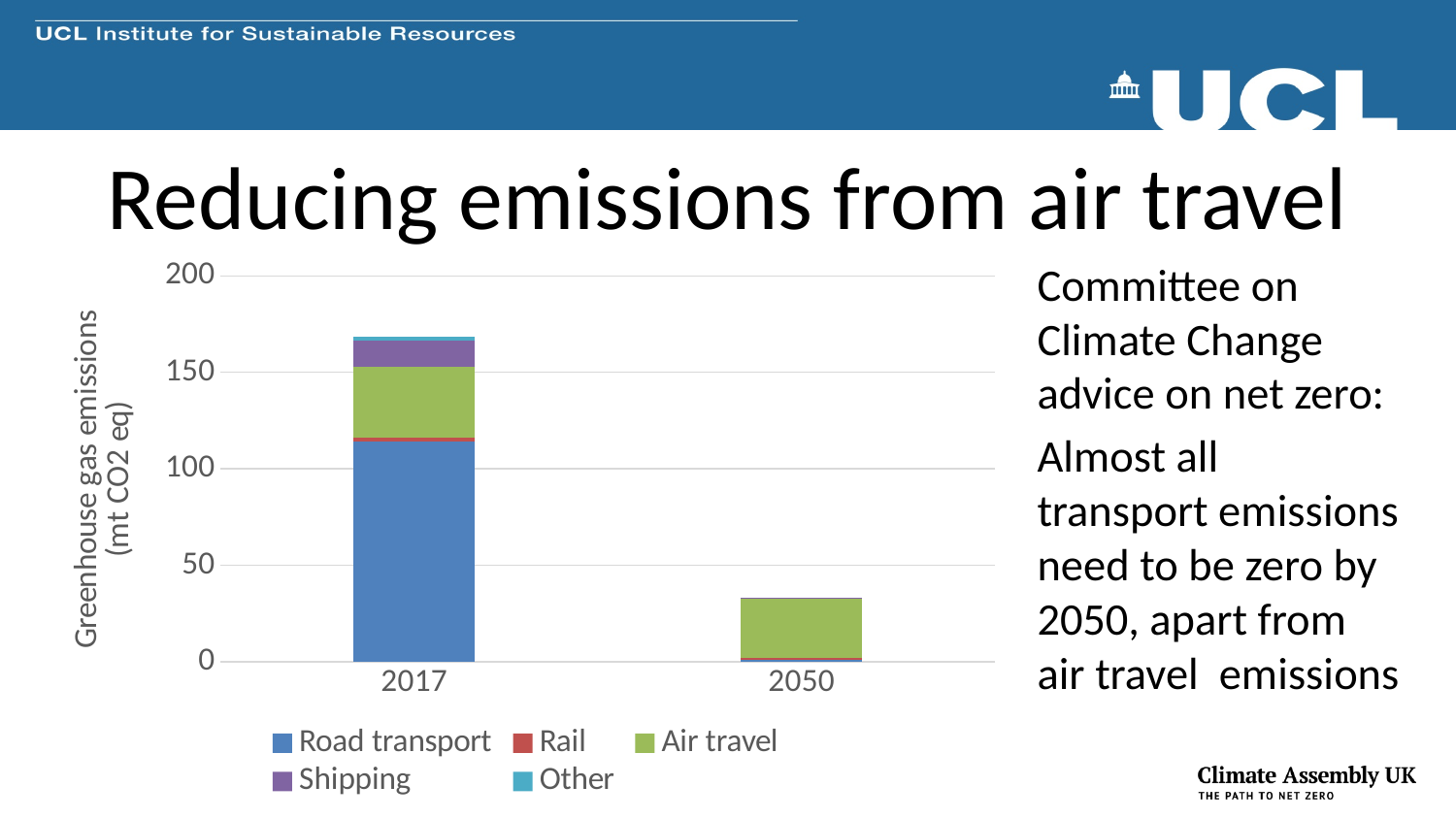
How many categories are shown on the x axis of the chart? 2 Is the total greenhouse gas emissions for 2017 greater or less than 150? greater How many series does the chart's legend list? 5 Which year has the lowest total greenhouse gas emissions? 2050 What kind of chart is shown on the slide? Stacked bar chart Which series in the legend is shown in green? Air travel Is the Air travel value for 2050 greater or less than 50? less Do total greenhouse gas emissions rise or fall from 2017 to 2050? fall What is the label on the y axis of the chart? Greenhouse gas emissions (mt CO2 eq) Which year has the higher total greenhouse gas emissions, 2017 or 2050? 2017 Is the Road transport value for 2017 greater or less than 100? greater